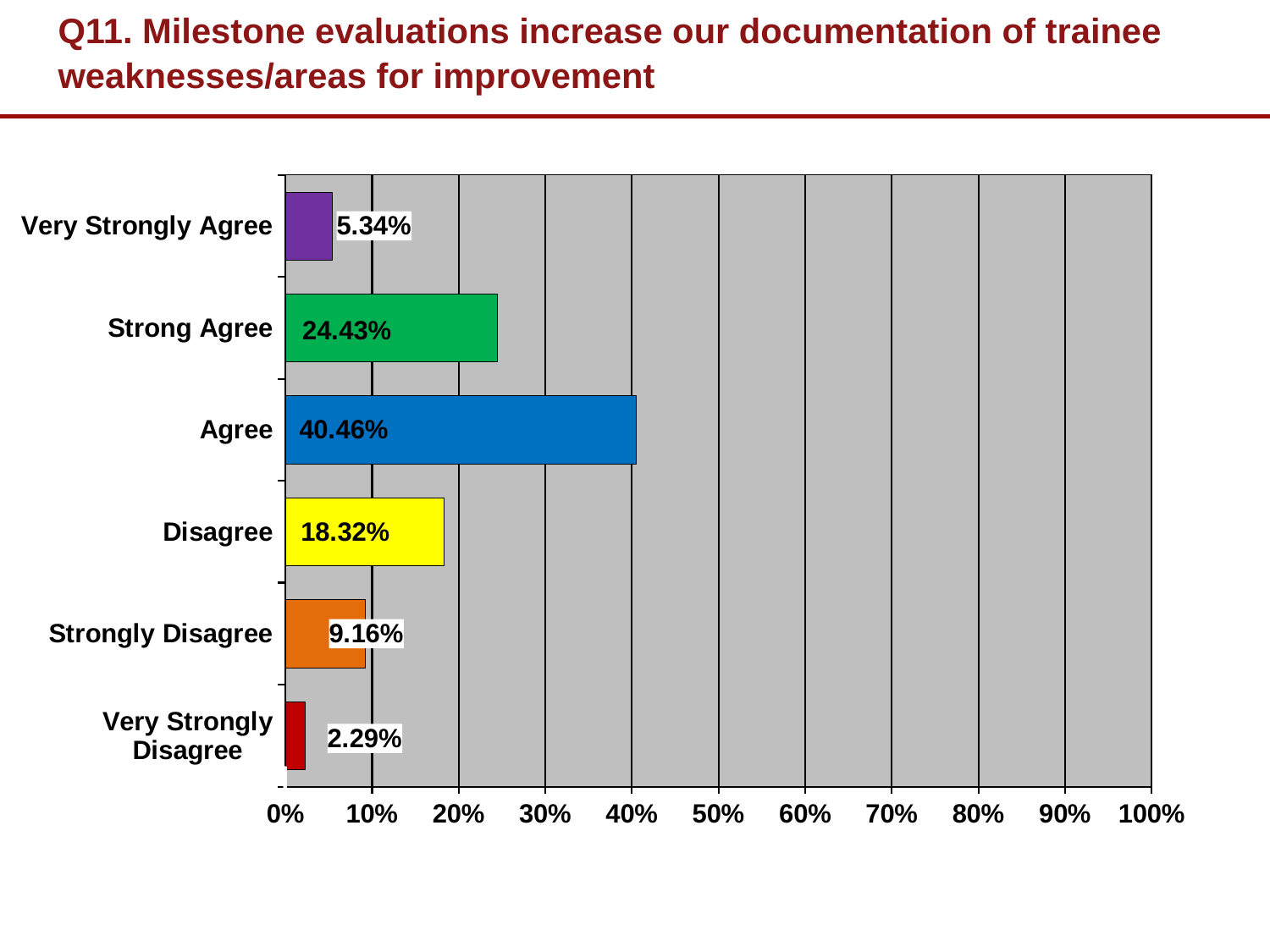
What kind of chart is shown on the slide? bar chart What is the value for Agree? 40.46% Which category has the highest value? Agree What colour is the bar for Disagree? yellow What is the value for Very Strongly Agree? 5.34% What is the difference between the values for Disagree and Strongly Disagree? 9.16% Which category has the lowest value? Very Strongly Disagree What is the difference between the values for Agree and Strong Agree? 16.03% Which is larger, the value for Strong Agree or the value for Disagree? Strong Agree How many categories are shown in the chart? 6 What is the value for Strongly Disagree? 9.16% Is the value for Agree greater or less than 30%? greater